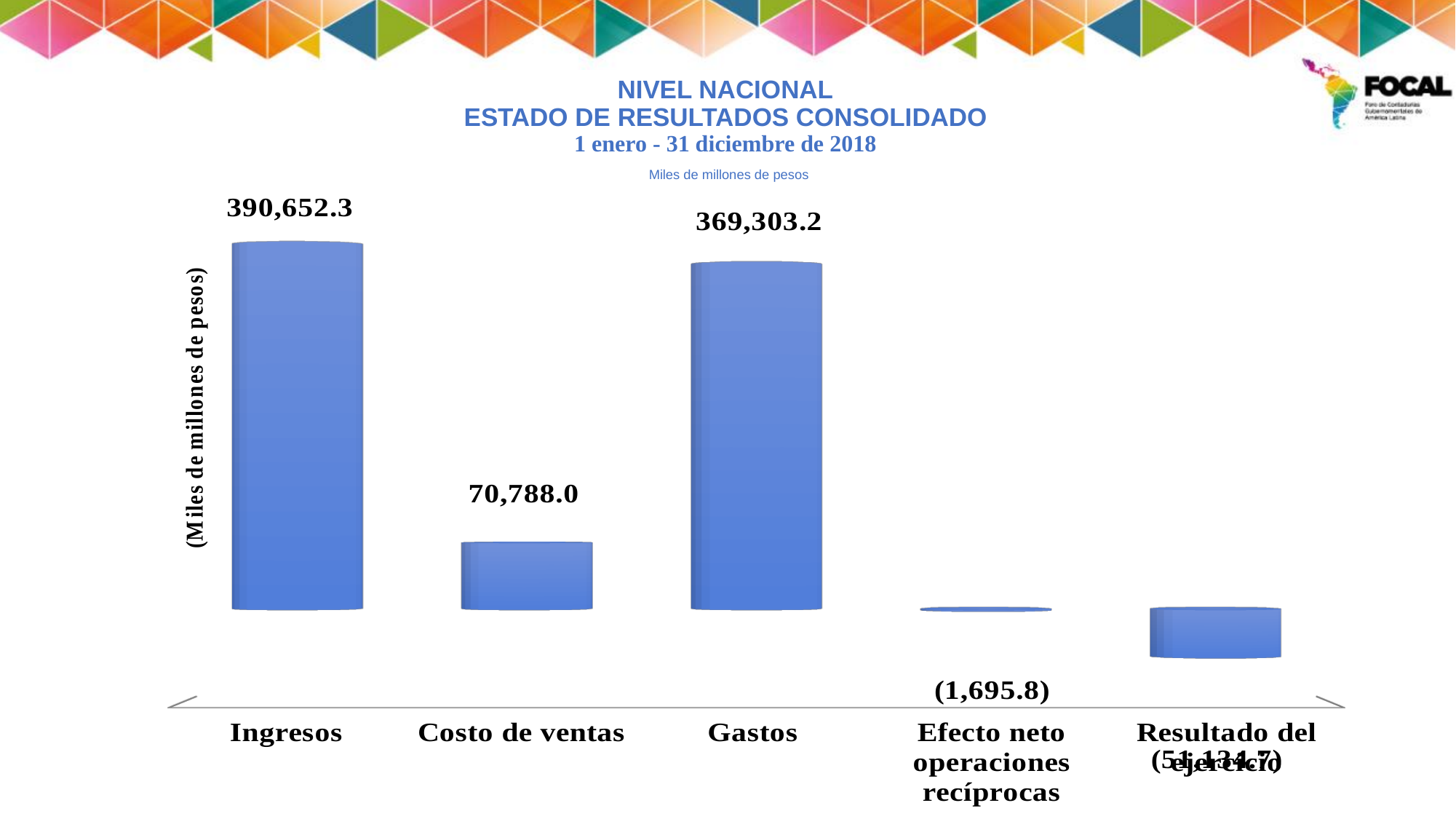
How many categories are shown on the x axis? 5 What is the difference between Ingresos and Gastos? 21,349.1 What is the value for Costo de ventas? 70,788.0 What is the value for Gastos? 369,303.2 What is the value for Ingresos? 390,652.3 Which is larger, Gastos or Costo de ventas? Gastos What kind of chart is shown on the slide? Bar chart What is the value for Efecto neto operaciones recíprocas? (1,695.8) What is the difference between Gastos and Costo de ventas? 298,515.2 Which category has the highest value? Ingresos What is the label on the vertical axis? (Miles de millones de pesos) Which category has the lowest value? Resultado del ejercicio